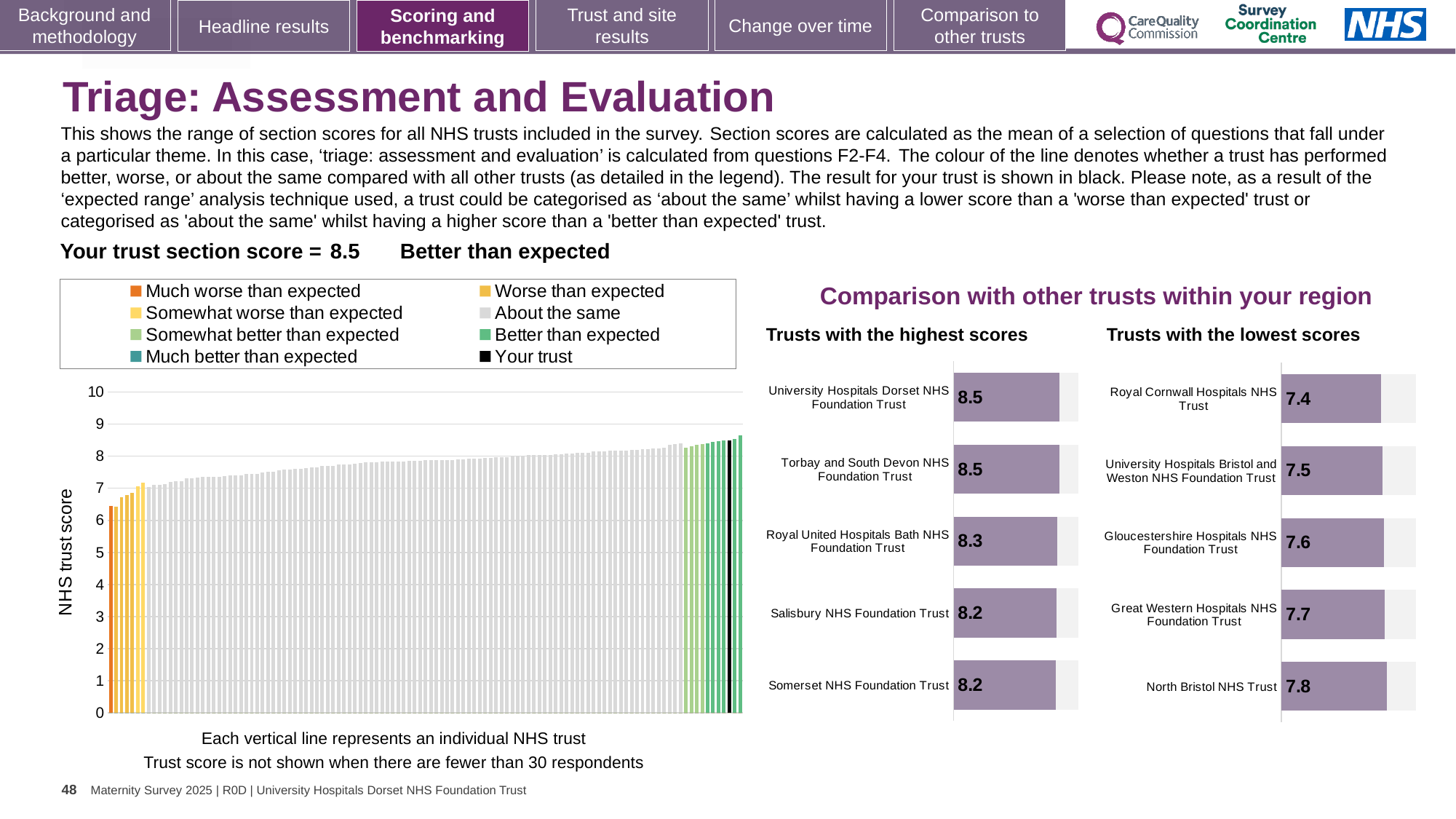
How many trusts are listed in the 'Trusts with the highest scores' chart? 5 What is the difference between the score for University Hospitals Dorset NHS Foundation Trust in the 'Trusts with the highest scores' chart and the score for Royal Cornwall Hospitals NHS Trust in the 'Trusts with the lowest scores' chart? 1.1 In the 'Trusts with the lowest scores' chart, which has the larger score: Great Western Hospitals NHS Foundation Trust or University Hospitals Bristol and Weston NHS Foundation Trust? Great Western Hospitals NHS Foundation Trust How many entries does the legend above the 'NHS trust score' chart list? 8 In the 'Trusts with the lowest scores' chart, what is the score for Gloucestershire Hospitals NHS Foundation Trust? 7.6 In the 'Trusts with the lowest scores' chart, which trust has the lowest score? Royal Cornwall Hospitals NHS Trust In the 'Trusts with the lowest scores' chart, which trust has the highest score? North Bristol NHS Trust In the 'NHS trust score' chart on the left, do the bar values rise or fall from left to right? Rise In the 'NHS trust score' chart on the left, is the value of the lowest bar greater or less than 7? less In the 'Trusts with the highest scores' chart, what is the difference between the score for University Hospitals Dorset NHS Foundation Trust and the score for Somerset NHS Foundation Trust? 0.3 In the 'Trusts with the highest scores' chart, what is the score for Royal United Hospitals Bath NHS Foundation Trust? 8.3 What kind of chart is the 'NHS trust score' chart on the left of the slide? Bar chart